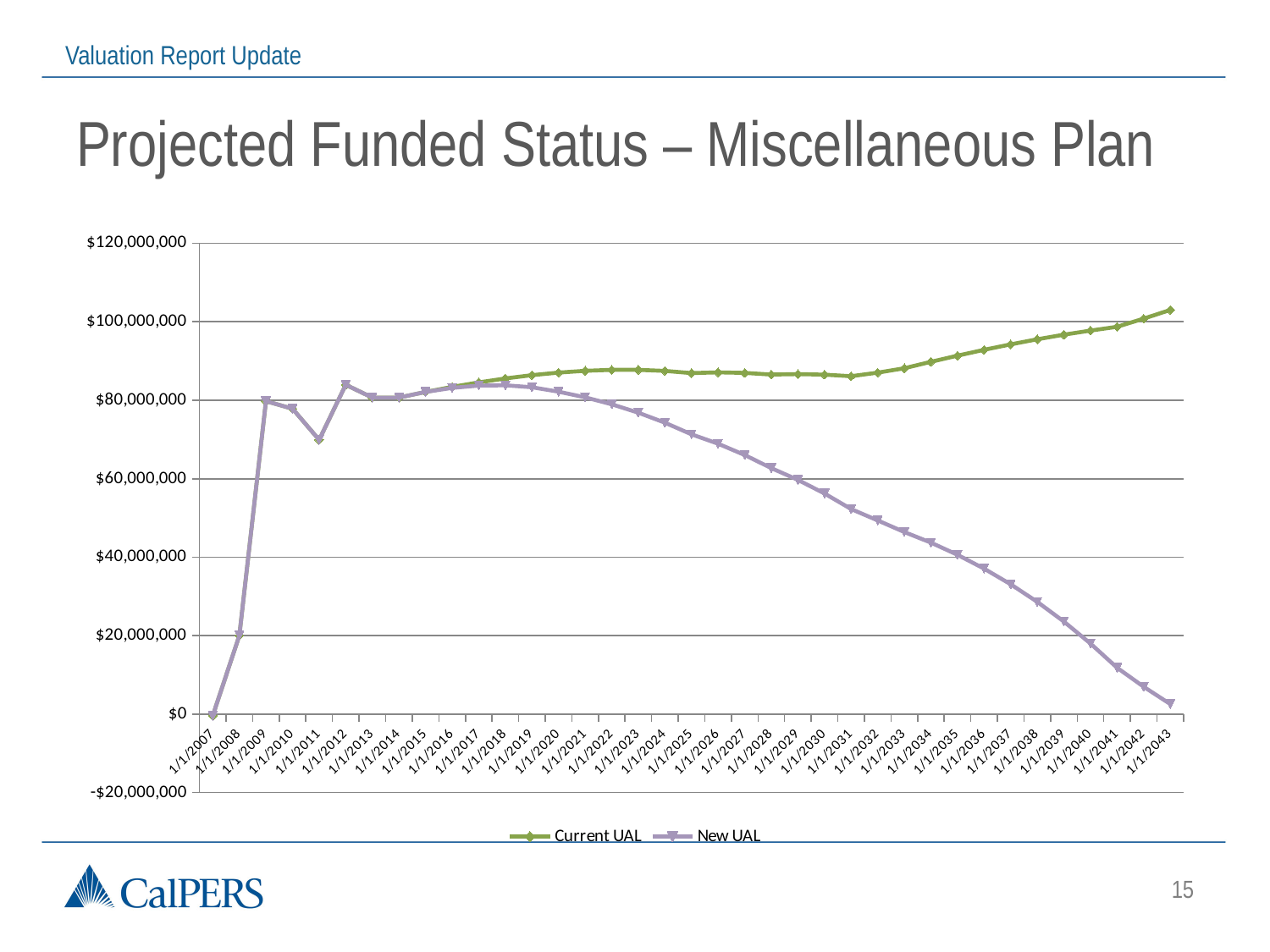
Is the value for New UAL at 1/1/2038 greater or less than $20,000,000? greater How many series does the legend list? 2 Is the value for New UAL at 1/1/2043 greater or less than $20,000,000? less What kind of chart is shown on the slide? line chart At which date does Current UAL reach its highest value? 1/1/2043 Is the value for New UAL at 1/1/2011 greater or less than $80,000,000? less At 1/1/2043, which series has the higher value, Current UAL or New UAL? Current UAL Does the New UAL line rise or fall from 1/1/2023 to 1/1/2043? fall Which two series are listed in the legend? Current UAL and New UAL How many dates are shown along the x axis? 37